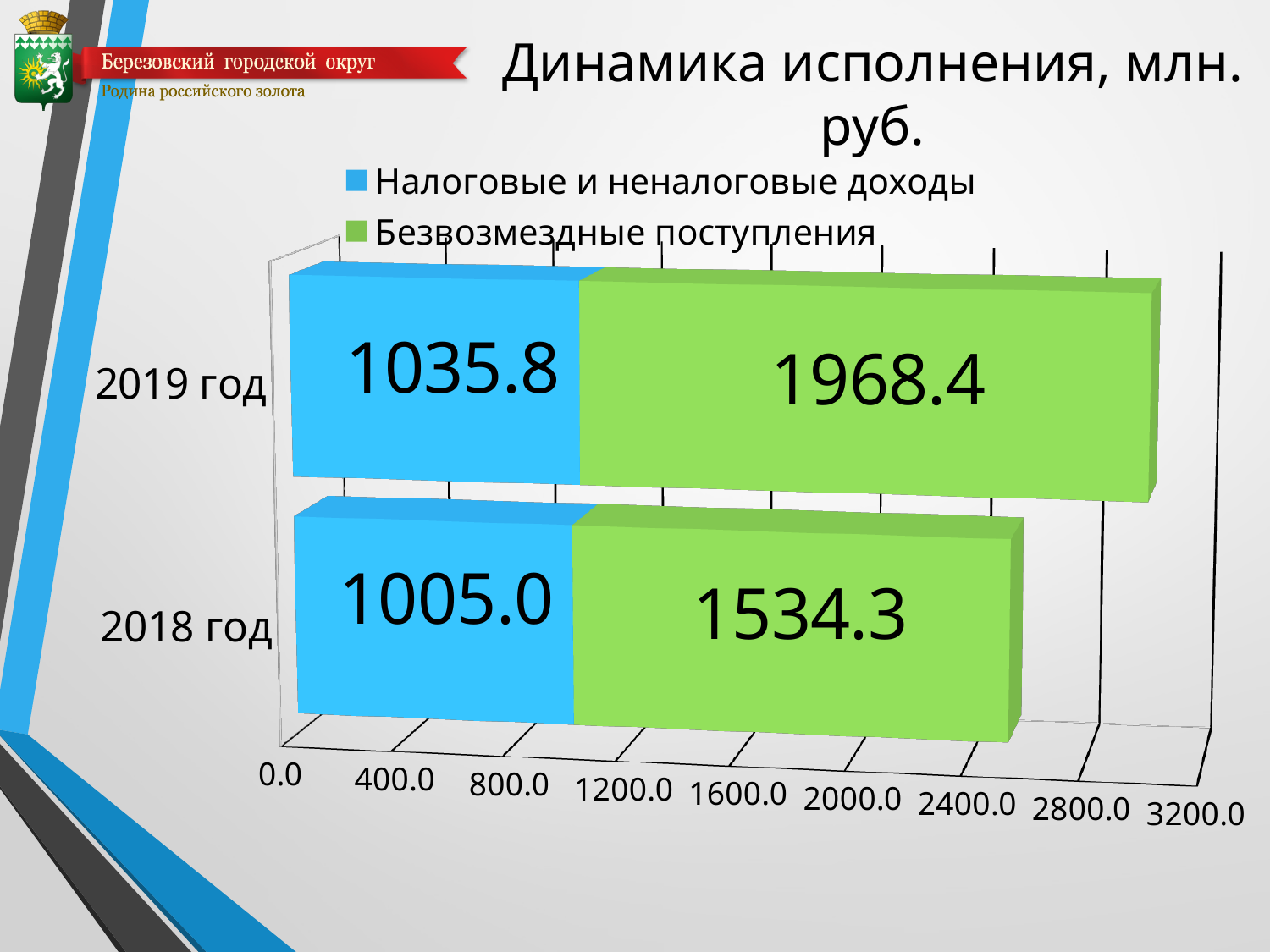
What is the value of Налоговые и неналоговые доходы for 2018 год? 1005.0 What is the total of the stacked bar for 2018 год? 2539.3 What is the difference between Безвозмездные поступления in 2019 год and 2018 год? 434.1 What is the value of Безвозмездные поступления for 2018 год? 1534.3 Which year has the higher value for Безвозмездные поступления? 2019 год What is the total of the stacked bar for 2019 год? 3004.2 What is the value of Налоговые и неналоговые доходы for 2019 год? 1035.8 What kind of chart is shown on the slide? Stacked bar chart Which is larger in 2018 год: Налоговые и неналоговые доходы or Безвозмездные поступления? Безвозмездные поступления What is the value of Безвозмездные поступления for 2019 год? 1968.4 What is the difference between Налоговые и неналоговые доходы in 2019 год and 2018 год? 30.8 How many series does the legend list? 2